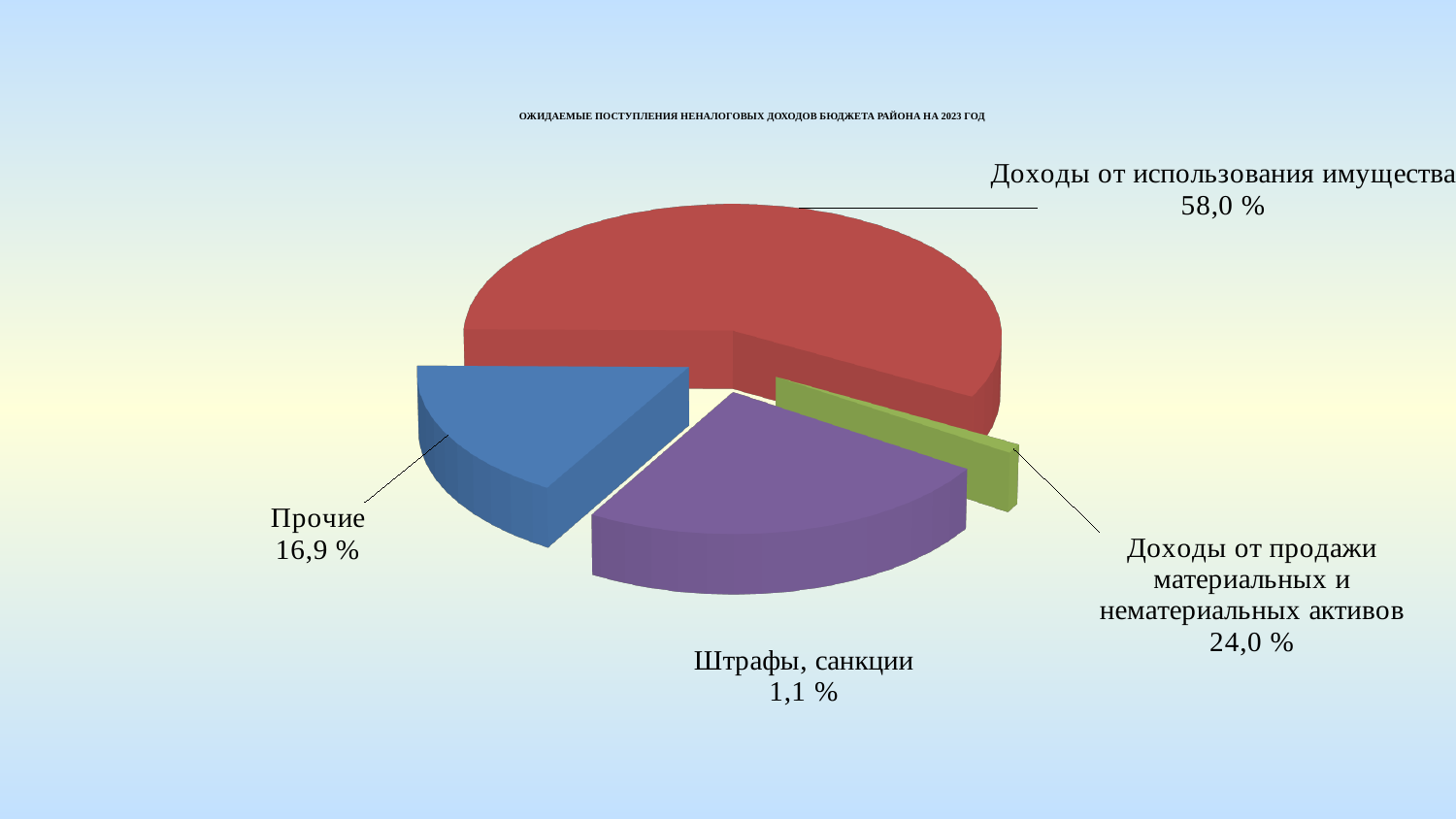
What is the share for Прочие? 16,9 % What year does the chart title refer to? 2023 What type of chart is shown on the slide? Pie chart How many categories are shown in the pie chart? 4 Which is larger: the share for Прочие or the share for Штрафы, санкции? Прочие Which category has the smallest share of the pie? Штрафы, санкции Which category has the largest share of the pie? Доходы от использования имущества What is the share for Доходы от продажи материальных и нематериальных активов? 24,0 % What is the share for Штрафы, санкции? 1,1 % What is the share for Доходы от использования имущества? 58,0 % What is the difference in percentage points between Доходы от продажи материальных и нематериальных активов and Прочие? 7,1 % What is the difference in percentage points between Доходы от использования имущества and Доходы от продажи материальных и нематериальных активов? 34,0 %